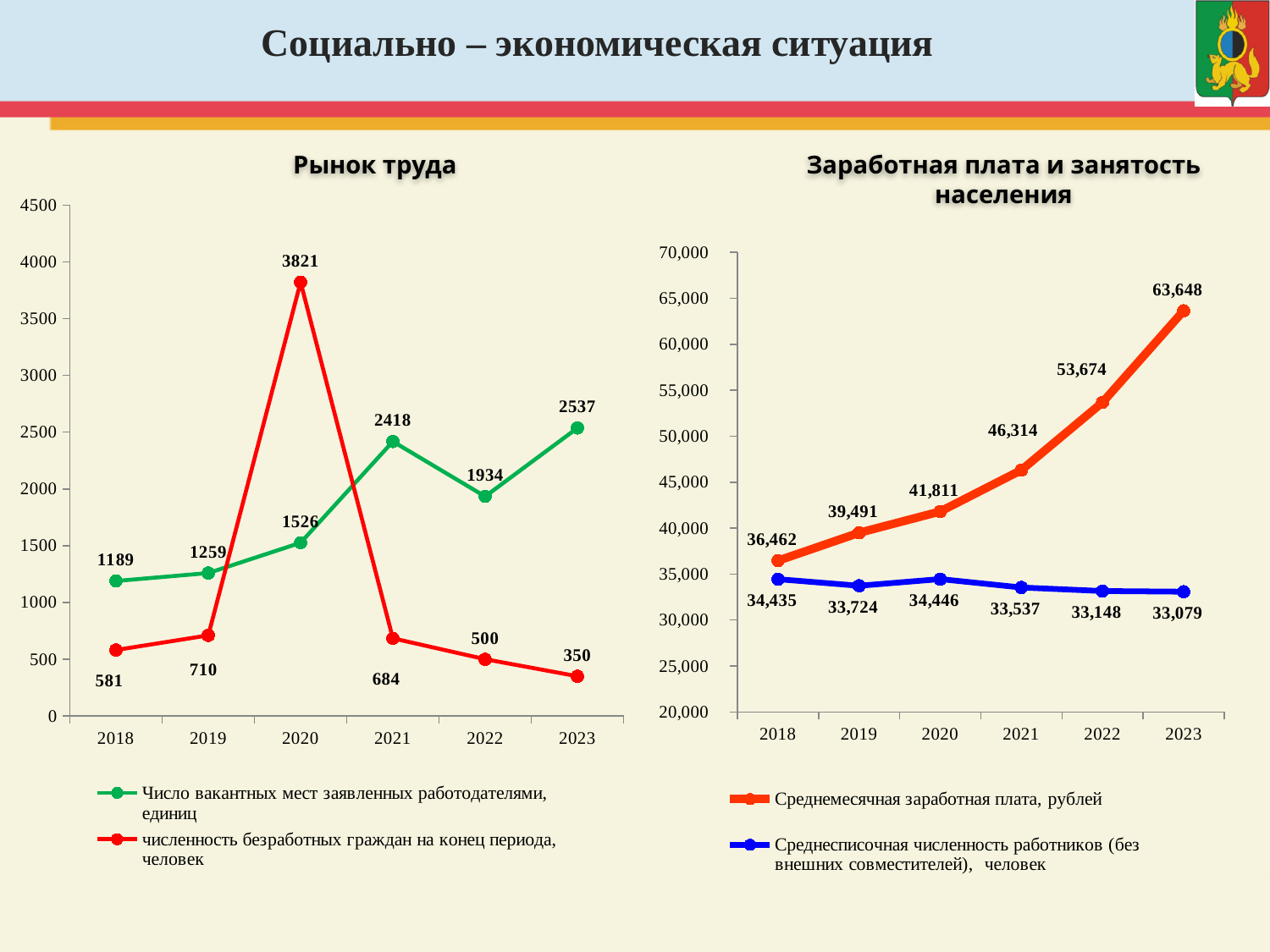
What type of chart is 'Рынок труда'? Line chart In the 'Рынок труда' chart, in which year is the number of vacancies (green line) highest? 2023 In the 'Рынок труда' chart, in which year is the number of unemployed citizens (red line) lowest? 2023 In the 'Рынок труда' chart, what is the value of 'численность безработных граждан на конец периода, человек' in 2020? 3821 In the 'Заработная плата и занятость населения' chart, what is the difference in average monthly salary between 2023 and 2018? 27,186 In the 'Рынок труда' chart, what is the difference between the number of vacancies and the number of unemployed citizens in 2021? 1734 In the 'Заработная плата и занятость населения' chart, how does the average monthly salary change from 2018 to 2023? It rises In the 'Заработная плата и занятость населения' chart, what is the average number of employees in 2020? 34,446 In the 'Рынок труда' chart, which is larger in 2019: the number of vacancies or the number of unemployed citizens? Number of vacancies (1259) In the 'Заработная плата и занятость населения' chart, what is the average monthly salary in 2023? 63,648 How many series does the legend of the 'Заработная плата и занятость населения' chart list? 2 In the 'Рынок труда' chart, what is the value of 'Число вакантных мест заявленных работодателями, единиц' in 2023? 2537